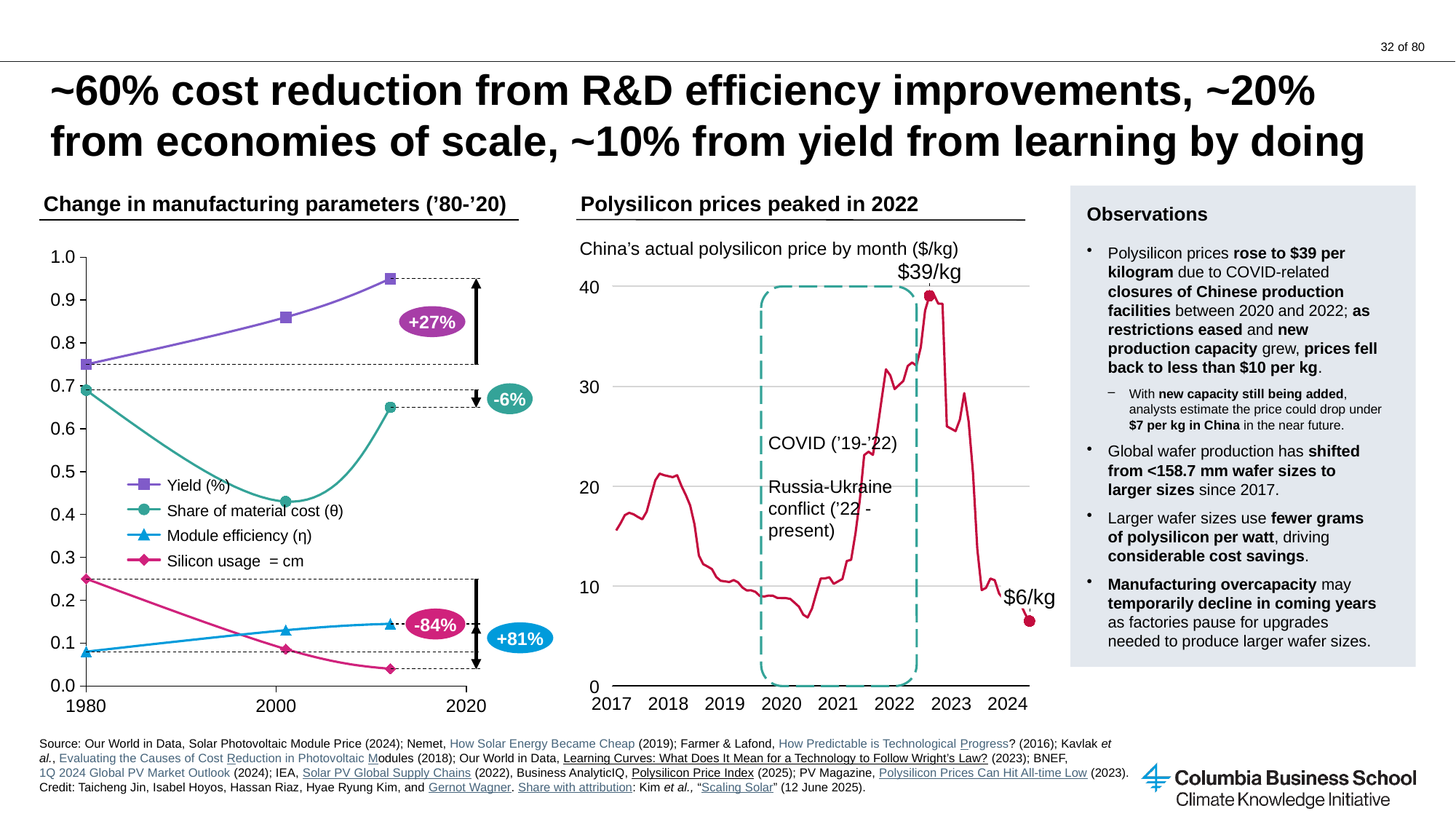
In the 'Polysilicon prices peaked in 2022' chart, what is the difference between the labelled peak price and the labelled 2024 price? $33/kg How many series does the legend of the 'Change in manufacturing parameters ('80-'20)' chart list? 4 In the 'Change in manufacturing parameters ('80-'20)' chart, what percentage change is labelled for Yield (%)? +27% In the 'Polysilicon prices peaked in 2022' chart, what is the labelled price at the end of the series in 2024? $6/kg In the 'Change in manufacturing parameters ('80-'20)' chart, is the Share of material cost (θ) value in 2000 greater or less than 0.5? less What kind of chart is the 'Change in manufacturing parameters ('80-'20)' chart? line chart In the 'Change in manufacturing parameters ('80-'20)' chart, is the Yield (%) value in 1980 greater or less than 0.7? greater In the 'Change in manufacturing parameters ('80-'20)' chart, what percentage change is labelled for Silicon usage? -84% In the 'Polysilicon prices peaked in 2022' chart, what is the labelled peak price? $39/kg In the 'Change in manufacturing parameters ('80-'20)' chart, what percentage change is labelled for Module efficiency (η)? +81% In the 'Change in manufacturing parameters ('80-'20)' chart, does Silicon usage rise or fall from 1980 to 2020? fall In the 'Change in manufacturing parameters ('80-'20)' chart, what percentage change is labelled for Share of material cost (θ)? -6%